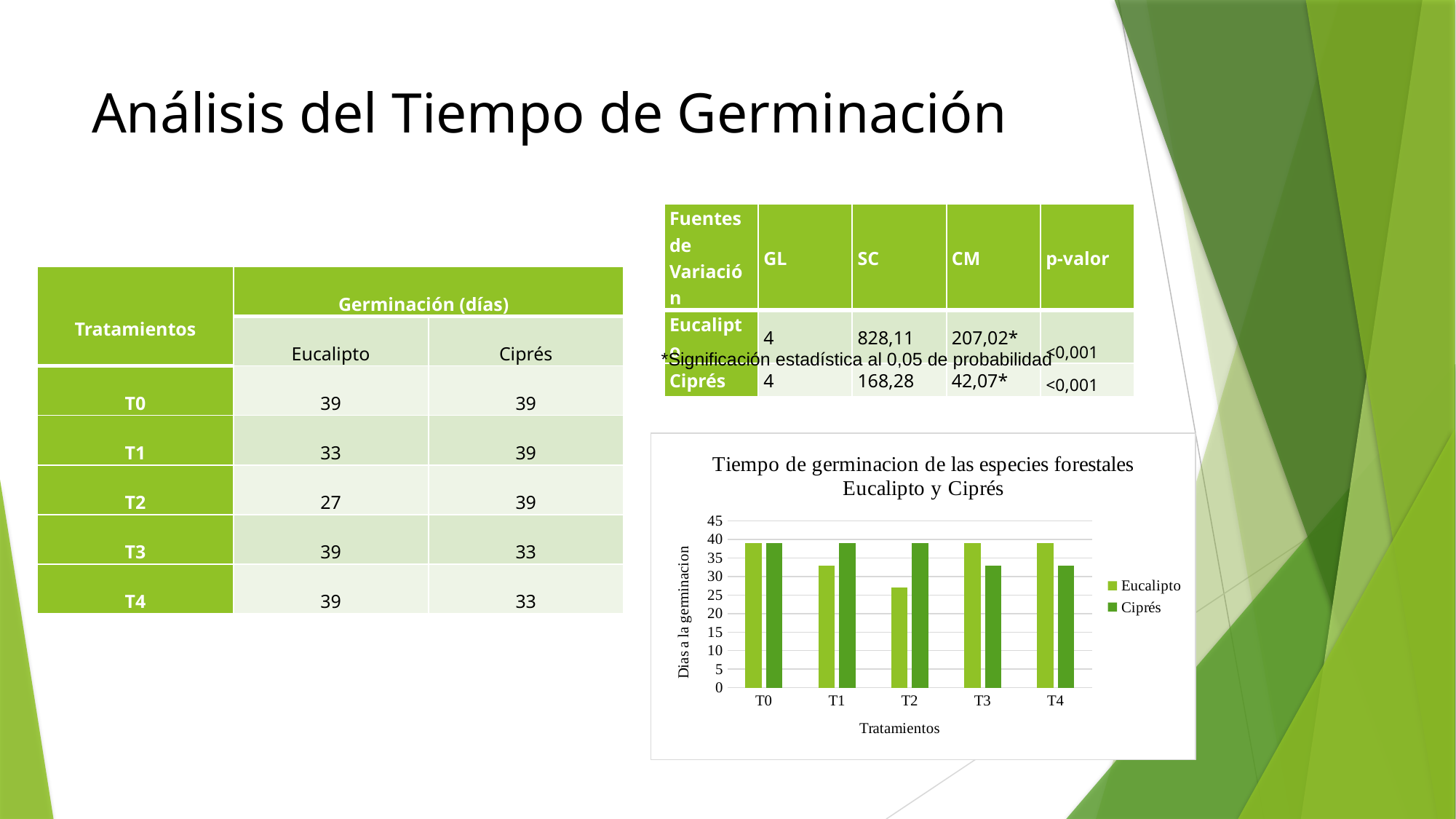
What is the Eucalipto germination time in days for T2? 27 Is the Ciprés value for T3 greater or less than 35? less What kind of chart is shown on the slide? bar chart What is the title of the chart? Tiempo de germinacion de las especies forestales Eucalipto y Ciprés For T4, which series has the larger value, Eucalipto or Ciprés? Eucalipto How many series does the chart legend list? 2 Is the Eucalipto value for T2 greater or less than 30? less What is the y-axis label of the chart? Dias a la germinacion Is the Eucalipto value for T0 greater or less than 35? greater For T1, which series has the larger value, Eucalipto or Ciprés? Ciprés Which treatment has the lowest Eucalipto value in the chart? T2 How many treatment categories are shown on the x axis of the chart? 5